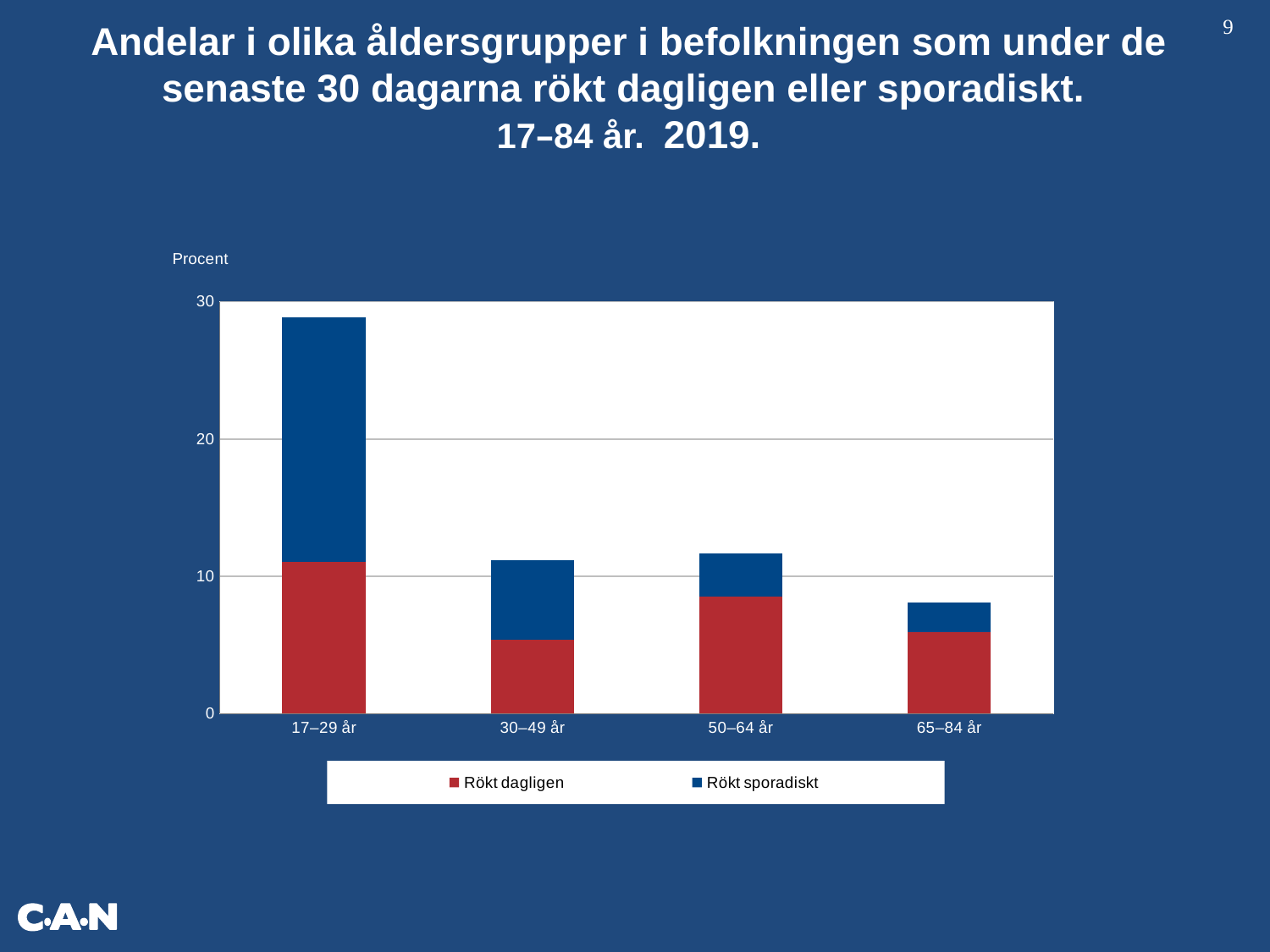
Is the total bar for 17–29 år greater or less than 20? greater Which age group has the highest total bar? 17–29 år Which age group has the lowest total bar? 65–84 år Is the total bar for 65–84 år greater or less than 10? less How many series does the legend list? 2 Which age group has the largest 'Rökt sporadiskt' segment? 17–29 år Is the 'Rökt dagligen' value for 50–64 år greater or less than 10? less How many age groups are shown on the x axis? 4 What kind of chart is shown on the slide? Stacked bar chart Which is larger, the 'Rökt dagligen' value for 50–64 år or for 30–49 år? 50–64 år What label is shown on the vertical axis? Procent Which is larger, the 'Rökt dagligen' value for 17–29 år or for 65–84 år? 17–29 år